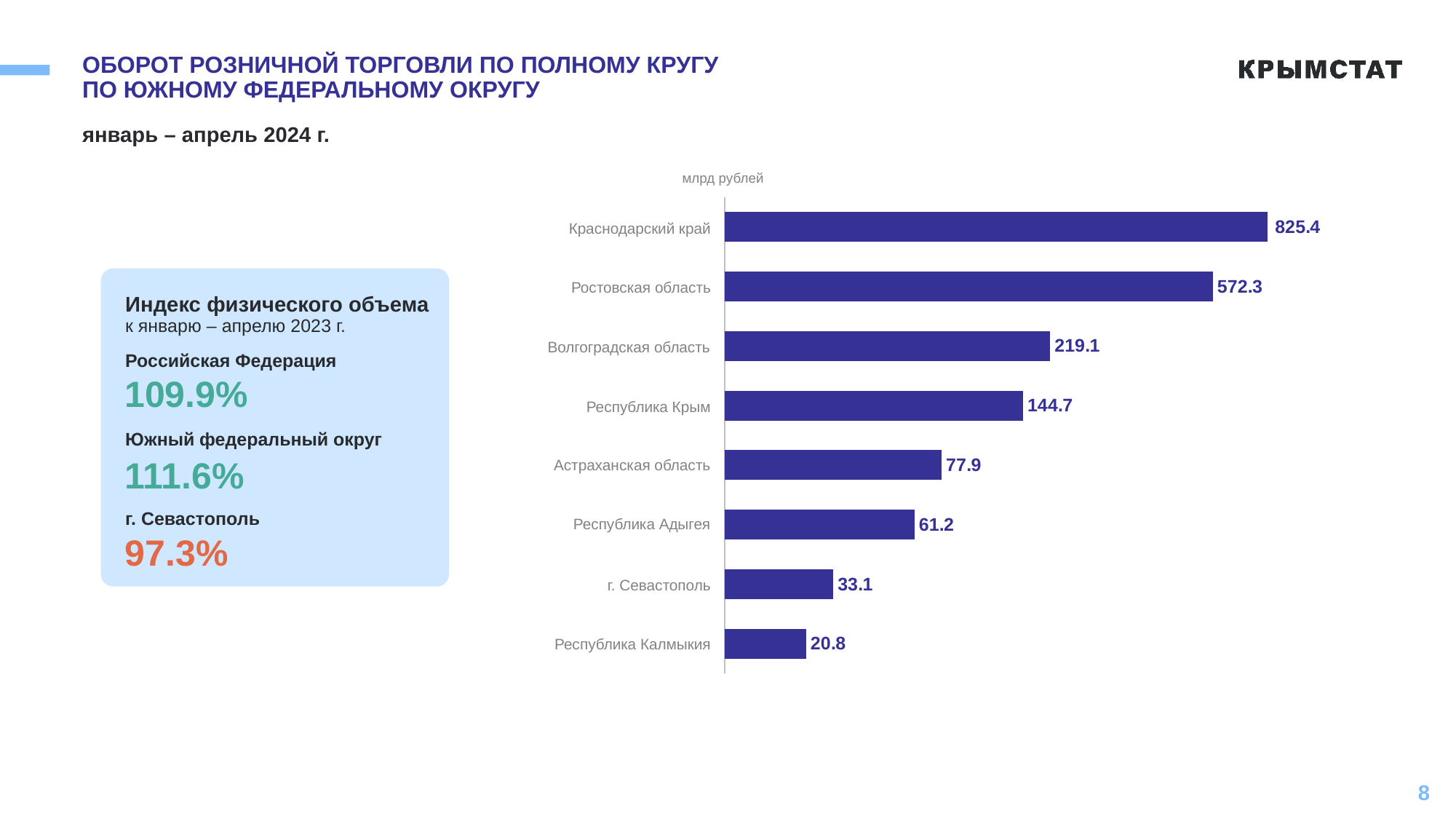
What type of chart is used to show retail trade turnover by region? bar chart What is the value shown for г. Севастополь? 33.1 What is the value shown for Республика Крым? 144.7 Do the bar values increase or decrease from top to bottom of the chart? decrease What unit of measurement is indicated above the bar chart? млрд рублей Which region has the lowest retail trade turnover on the chart? Республика Калмыкия What is the retail trade turnover value for Краснодарский край? 825.4 What is the difference between the values for Республика Крым and г. Севастополь? 111.6 How many regions are shown on the bar chart? 8 Which has a larger value, Астраханская область or Республика Адыгея? Астраханская область Which region has the highest retail trade turnover on the chart? Краснодарский край What is the difference between the values for Краснодарский край and Ростовская область? 253.1